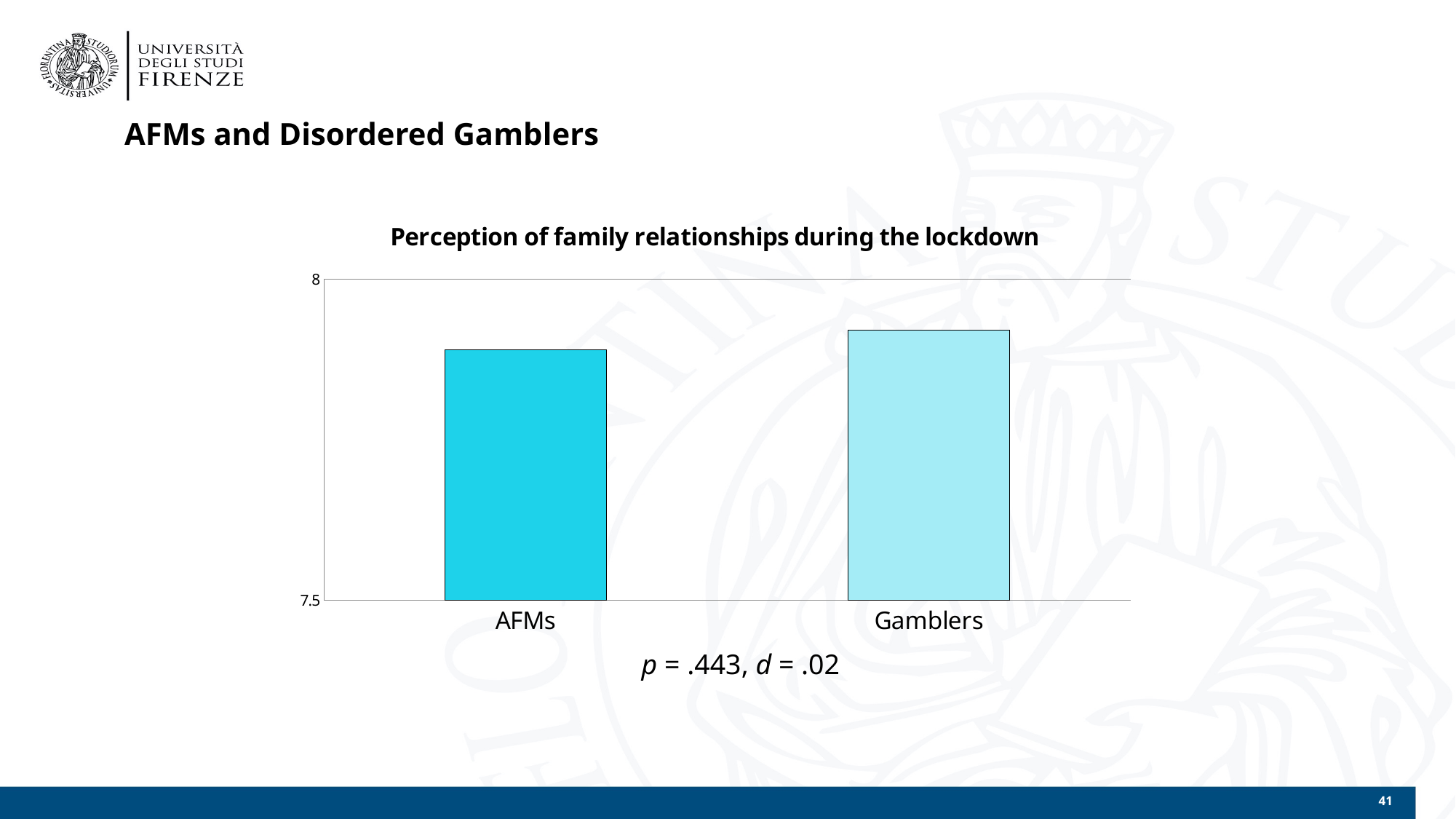
Which category has the lowest value in the chart? AFMs What is the title of the chart? Perception of family relationships during the lockdown How many categories are plotted in the chart? 2 Which category has the highest value in the chart? Gamblers What kind of chart is shown on the slide? bar chart What is the lowest value shown on the y axis? 7.5 Is the value for AFMs greater or less than 8? less Which category has the higher bar, AFMs or Gamblers? Gamblers What is the highest value shown on the y axis? 8 Is the value for Gamblers greater or less than 7.5? greater What are the two categories shown on the x axis? AFMs and Gamblers Is the value for Gamblers greater or less than 8? less